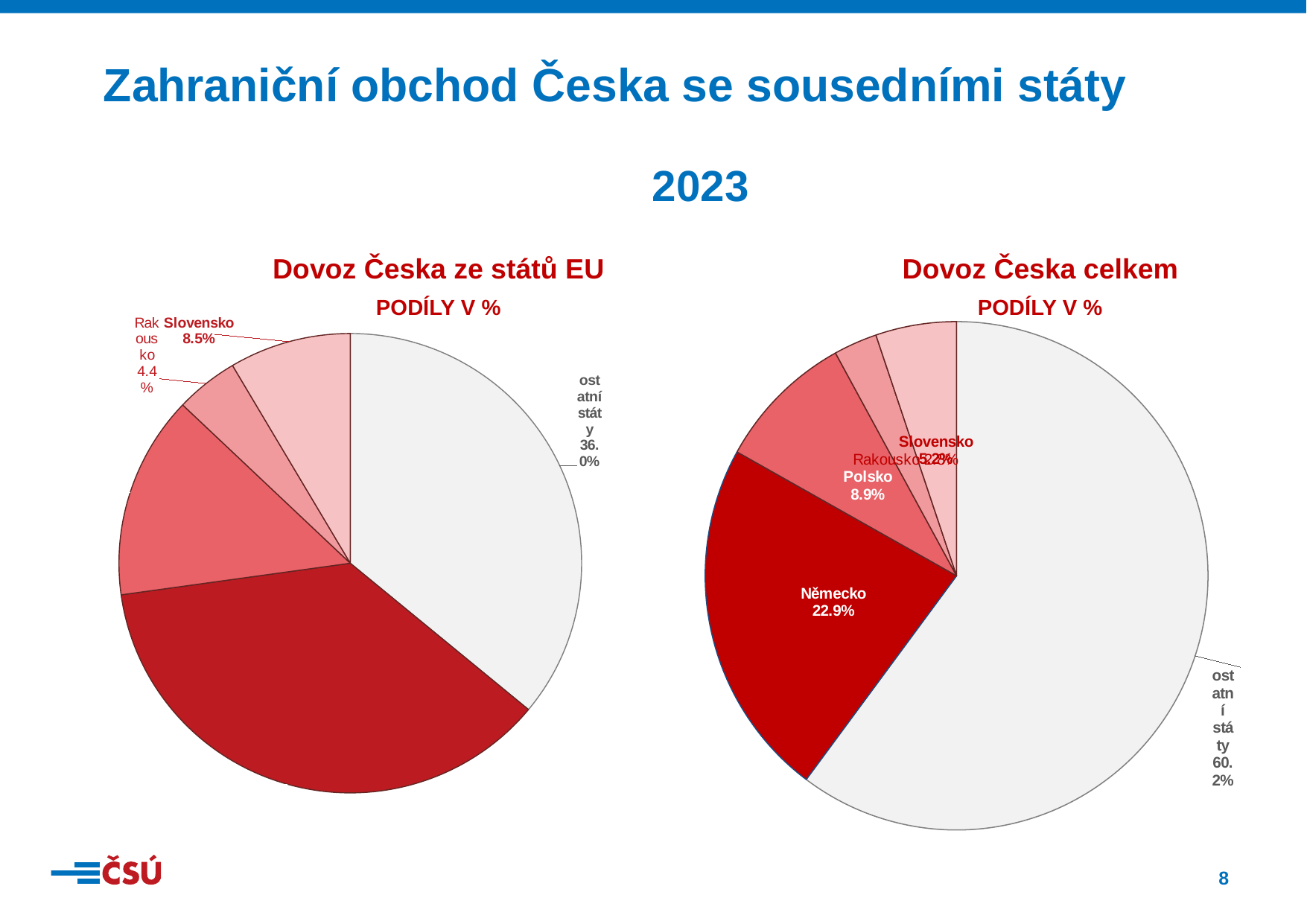
In the 'Dovoz Česka celkem' chart, how many percentage points larger is Německo's share than Polsko's? 14.0 percentage points In the 'Dovoz Česka ze států EU' chart, what share does Slovensko have? 8.5% In the 'Dovoz Česka celkem' chart, what share does Německo have? 22.9% In the 'Dovoz Česka celkem' chart, what share does Slovensko have? 5.2% In the 'Dovoz Česka ze států EU' chart, which has the larger share, Slovensko or Rakousko? Slovensko In the 'Dovoz Česka celkem' chart, what share does Polsko have? 8.9% What type of chart is used on this slide for 'Dovoz Česka celkem'? pie chart In the 'Dovoz Česka ze států EU' chart, what share does Rakousko have? 4.4% In the 'Dovoz Česka celkem' chart, what share do ostatní státy have? 60.2% In the 'Dovoz Česka ze států EU' chart, what share do ostatní státy have? 36.0% How many pie charts are shown on the slide? 2 In the 'Dovoz Česka celkem' chart, which slice is the largest? ostatní státy